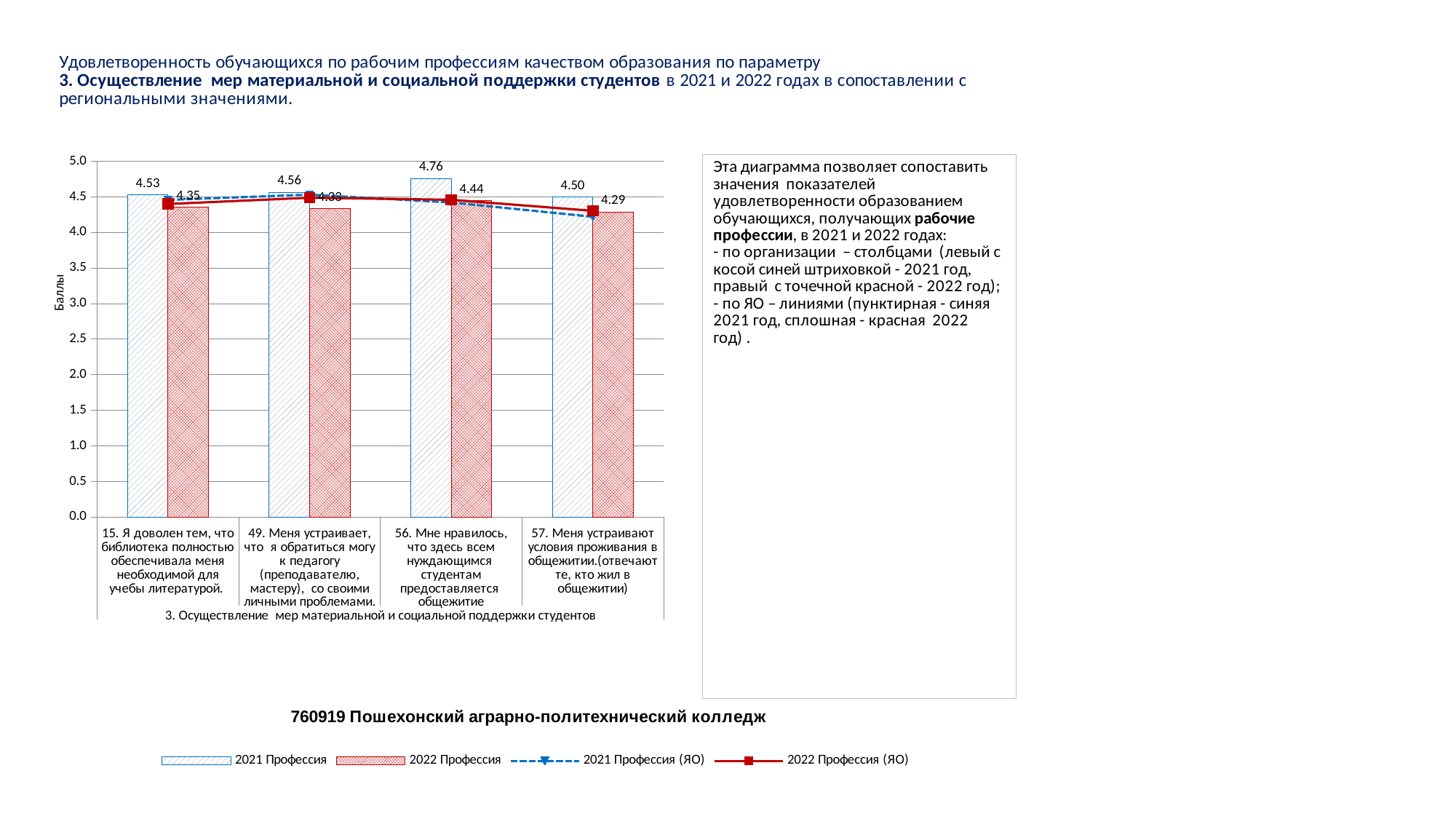
How many question categories are shown on the x axis? 4 How many series does the legend list? 4 Which question has the lowest 2022 Профессия bar? 57. Меня устраивают условия проживания в общежитии What is the label of the vertical axis? Баллы What is the value of the 2021 Профессия bar for question 15 (Я доволен тем, что библиотека полностью обеспечивала меня необходимой для учебы литературой)? 4.53 Is the 2021 Профессия (ЯО) line value for question 57 greater or less than 4.5? less Which question has the highest 2021 Профессия bar? 56. Мне нравилось, что здесь всем нуждающимся студентам предоставляется общежитие What is the value of the 2022 Профессия bar for question 57 (Меня устраивают условия проживания в общежитии)? 4.29 What is the value of the 2021 Профессия bar for question 56 (Мне нравилось, что здесь всем нуждающимся студентам предоставляется общежитие)? 4.76 What is the value of the 2022 Профессия bar for question 15? 4.35 For question 15, which is larger: the 2021 Профессия bar or the 2022 Профессия bar? 2021 Профессия What is the difference between the 2021 Профессия and 2022 Профессия values for question 56? 0.32